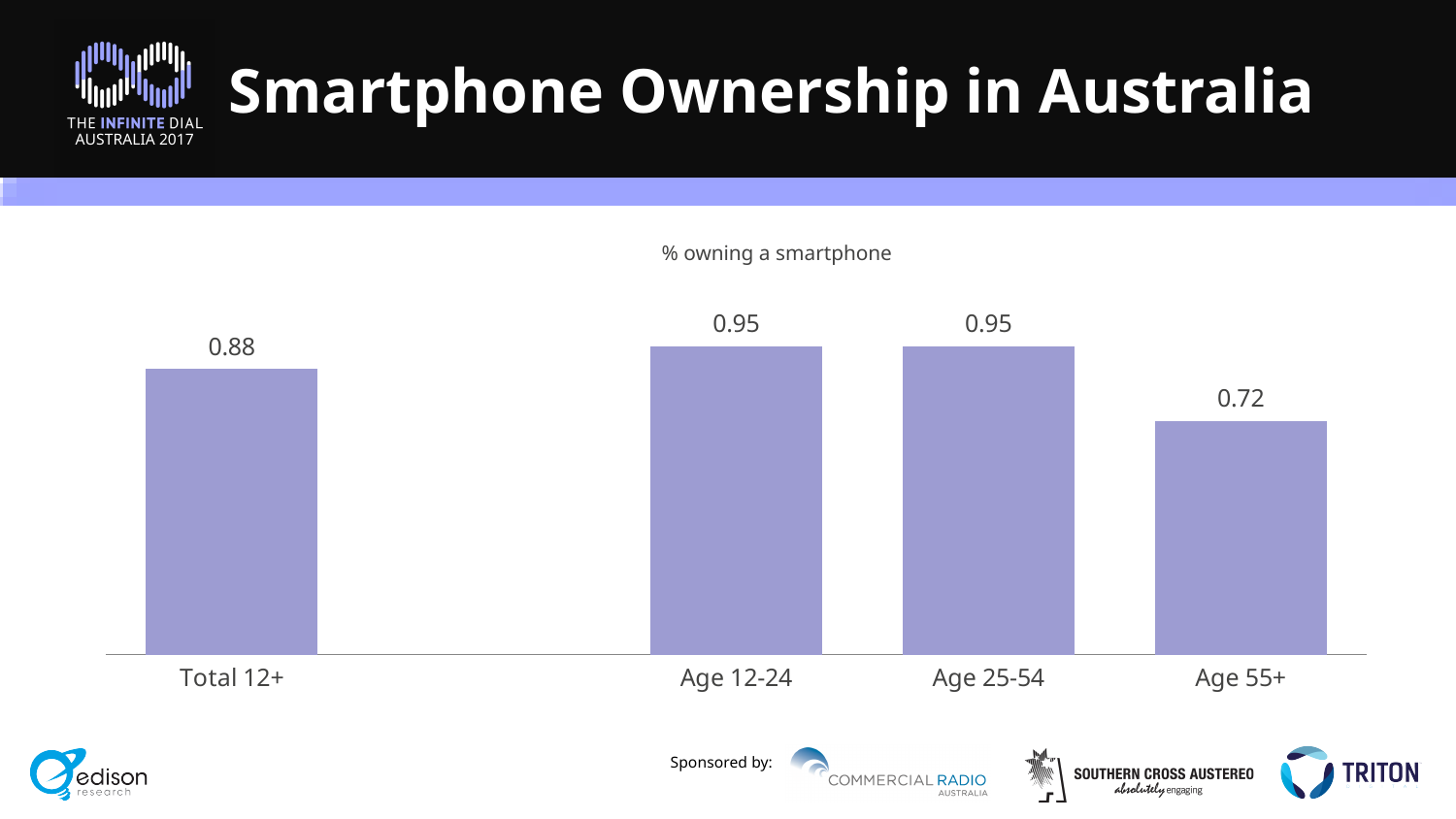
What is the value for Total 12+ in the chart? 0.88 What is the difference between the values for Age 25-54 and Age 55+? 0.23 Which is larger, the value for Total 12+ or the value for Age 55+? Total 12+ What is the difference between the values for Total 12+ and Age 55+? 0.16 What is the value for Age 25-54? 0.95 How many categories are shown in the chart? 4 What is the title of the chart? % owning a smartphone What kind of chart is shown on the slide? Bar chart Which two categories share the highest value? Age 12-24 and Age 25-54 Which category has the lowest value? Age 55+ What is the value for Age 12-24? 0.95 What is the value for Age 55+? 0.72